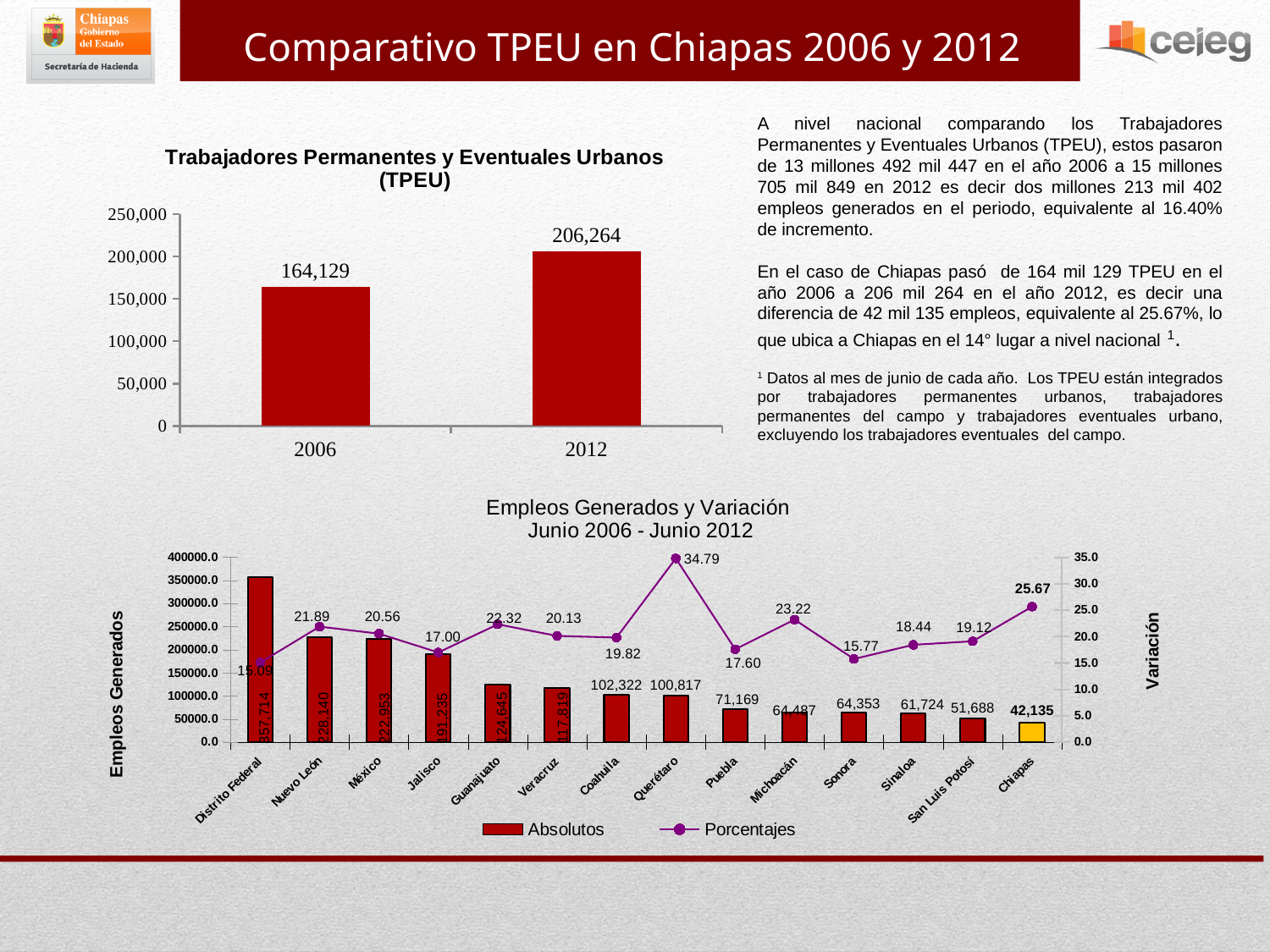
In the chart titled 'Empleos Generados y Variación Junio 2006 - Junio 2012', what is the Absolutos value for Chiapas? 42,135 In the chart titled 'Empleos Generados y Variación Junio 2006 - Junio 2012', is the Absolutos value for Distrito Federal greater or less than 300000.0? greater In the chart titled 'Empleos Generados y Variación Junio 2006 - Junio 2012', what is the Porcentajes value for Chiapas? 25.67 How many series does the legend of the chart titled 'Empleos Generados y Variación Junio 2006 - Junio 2012' list? 2 In the chart titled 'Trabajadores Permanentes y Eventuales Urbanos (TPEU)', what is the value for 2012? 206,264 In the chart titled 'Empleos Generados y Variación Junio 2006 - Junio 2012', what is the Porcentajes value for Querétaro? 34.79 What kind of chart is the one titled 'Trabajadores Permanentes y Eventuales Urbanos (TPEU)'? bar chart How many states are shown on the x axis of the chart titled 'Empleos Generados y Variación Junio 2006 - Junio 2012'? 14 In the chart titled 'Trabajadores Permanentes y Eventuales Urbanos (TPEU)', what is the value for 2006? 164,129 In the chart titled 'Empleos Generados y Variación Junio 2006 - Junio 2012', do the Absolutos bars rise or fall from Distrito Federal to Chiapas? fall In the chart titled 'Empleos Generados y Variación Junio 2006 - Junio 2012', which state has the highest Porcentajes value? Querétaro In the chart titled 'Trabajadores Permanentes y Eventuales Urbanos (TPEU)', what is the difference between the 2012 and 2006 values? 42,135